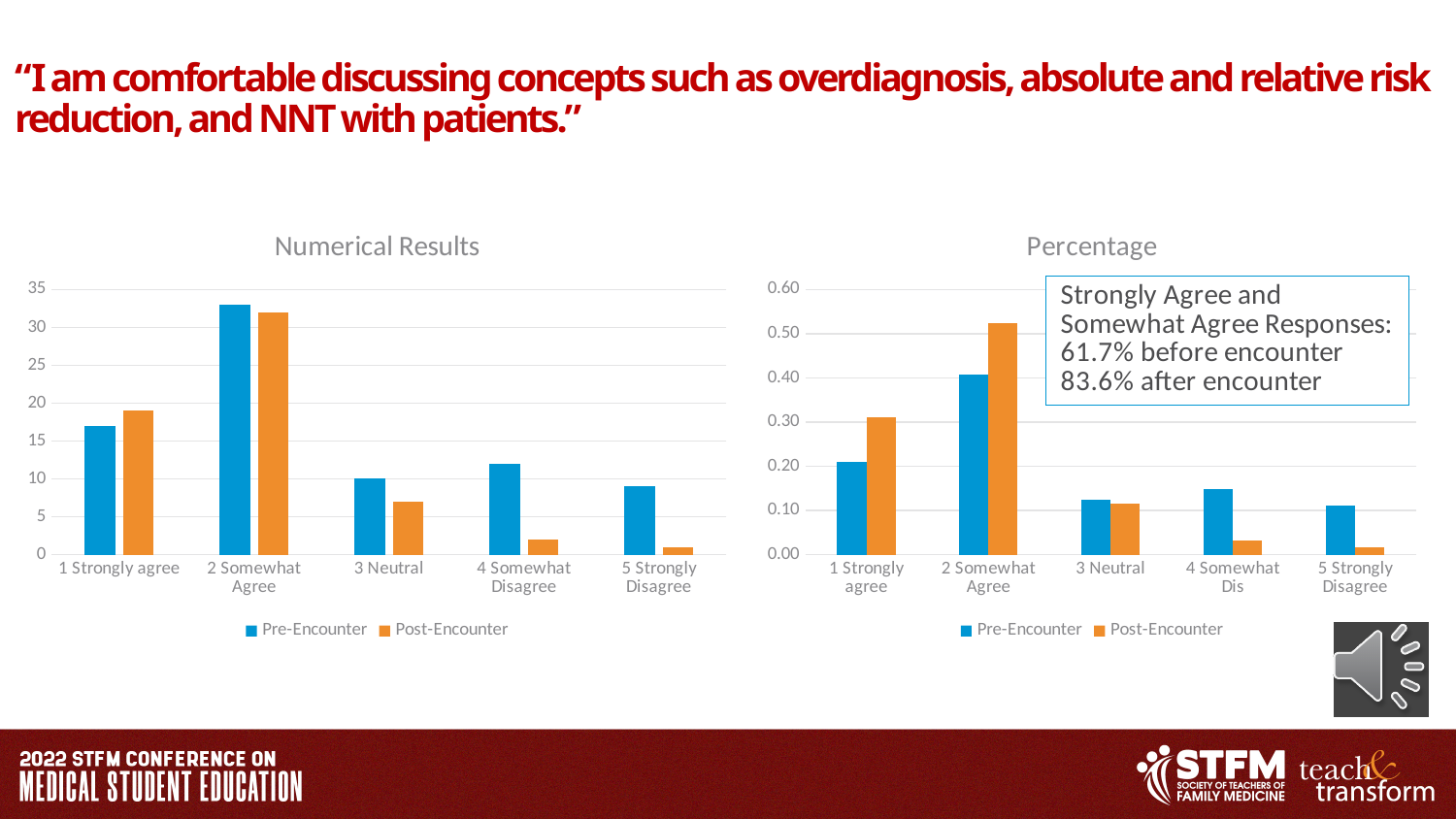
In the "Numerical Results" chart, which category has the highest Pre-Encounter value? 2 Somewhat Agree In the "Percentage" chart, for "4 Somewhat Dis", which is larger: Pre-Encounter or Post-Encounter? Pre-Encounter In the "Numerical Results" chart, is the Post-Encounter value for "4 Somewhat Disagree" greater or less than 5? less How many categories are shown on the x axis of the "Numerical Results" chart? 5 In the "Numerical Results" chart, which category has the lowest Post-Encounter value? 5 Strongly Disagree In the "Percentage" chart, is the Pre-Encounter value for "1 Strongly agree" greater or less than 0.30? less In the "Numerical Results" chart, is the Pre-Encounter value for "2 Somewhat Agree" greater or less than 30? greater According to the text box on the "Percentage" chart, what share of responses were Strongly Agree or Somewhat Agree after the encounter? 83.6% How many series does the legend of the "Percentage" chart list? 2 What kind of chart is the "Numerical Results" chart? bar chart In the "Numerical Results" chart, for "1 Strongly agree", which is larger: Pre-Encounter or Post-Encounter? Post-Encounter